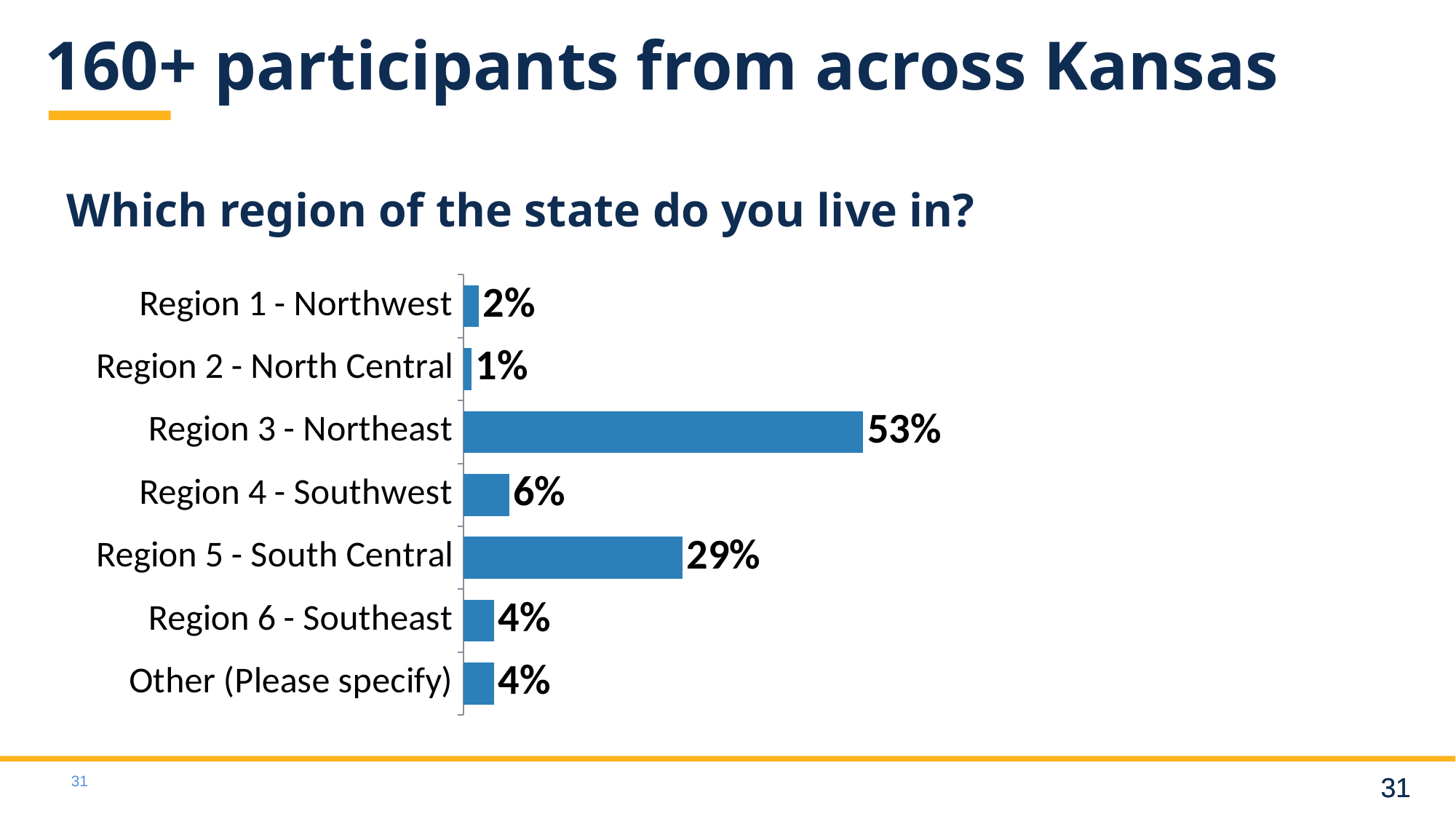
Which has a larger share of participants, Region 5 - South Central or Region 4 - Southwest? Region 5 - South Central What percentage of participants live in Region 3 - Northeast? 53% What question does the chart answer, as stated above it? Which region of the state do you live in? Which region has the lowest share of participants? Region 2 - North Central What is the difference in percentage points between Region 4 - Southwest and Region 1 - Northwest? 4 What is the difference in percentage points between Region 3 - Northeast and Region 5 - South Central? 24 What percentage of participants live in Region 5 - South Central? 29% What percentage of participants live in Region 4 - Southwest? 6% What type of chart is shown on the slide? Bar chart What percentage of participants live in Region 2 - North Central? 1% How many categories are shown in the chart? 7 Which region has the highest share of participants? Region 3 - Northeast